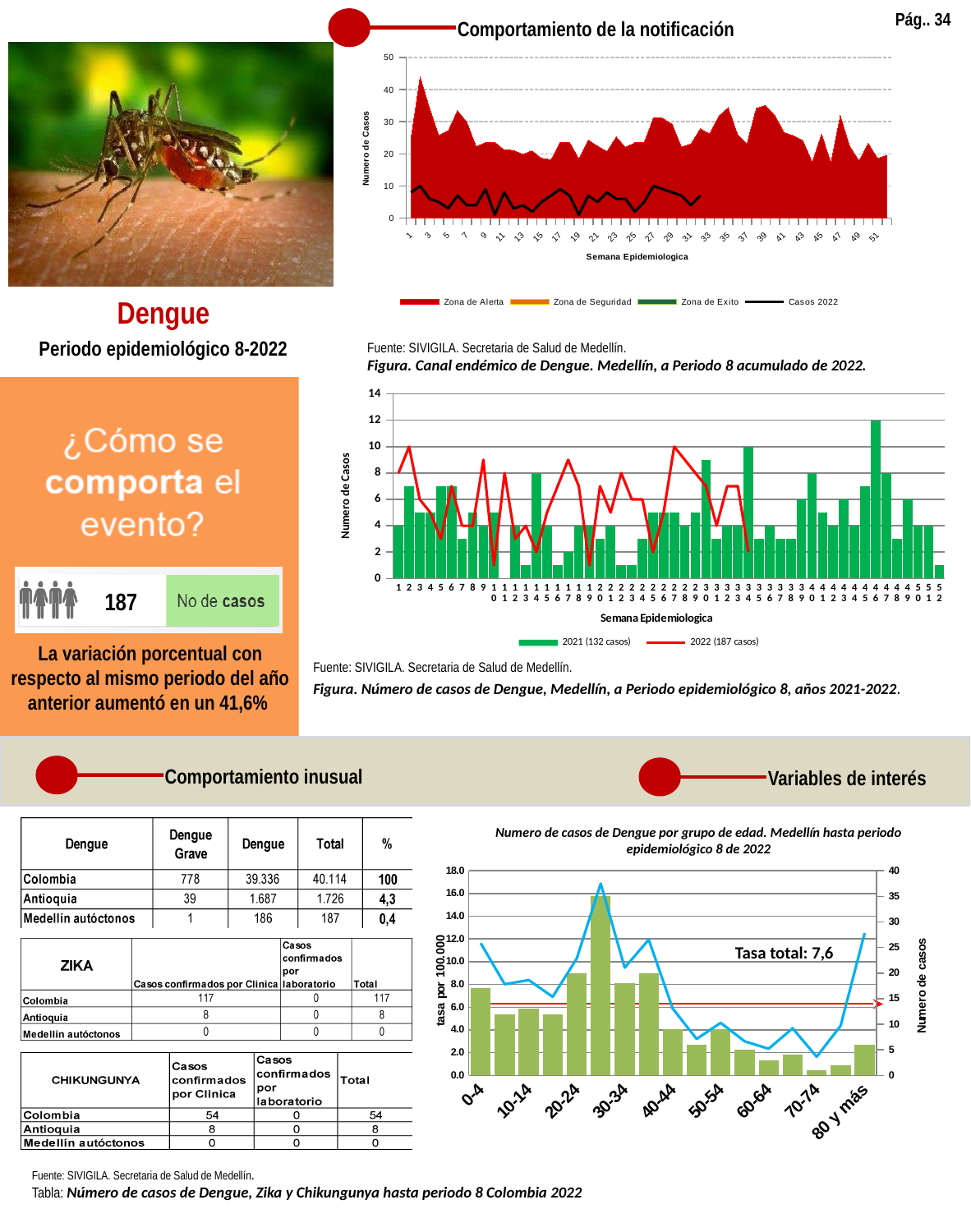
In the 'Número de casos de Dengue, Medellín, a Periodo epidemiológico 8, años 2021-2022' chart, how many total cases does the legend give for 2021? 132 casos In the 'Numero de casos de Dengue por grupo de edad' chart at the bottom right, is the rate (tasa por 100.000) line value for the 0-4 age group greater or less than 10? greater In the 'Canal endémico de Dengue' chart at the top right, is the Zona de Alerta value at week 2 greater or less than 30? greater In the 'Número de casos de Dengue, Medellín, a Periodo epidemiológico 8, años 2021-2022' chart, how many total cases does the legend give for 2022? 187 casos In the 'Número de casos de Dengue, Medellín, a Periodo epidemiológico 8, años 2021-2022' chart, what colour are the 2021 bars? green In the 'Número de casos de Dengue, Medellín, a Periodo epidemiológico 8, años 2021-2022' chart, what is the difference between the 2022 and 2021 totals shown in the legend? 55 In the 'Numero de casos de Dengue por grupo de edad' chart at the bottom right, how many bars are plotted? 17 In the 'Canal endémico de Dengue' chart at the top right, what is the label of the x axis? Semana Epidemiologica In the 'Numero de casos de Dengue por grupo de edad' chart at the bottom right, what is the Tasa total shown? 7,6 In the 'Canal endémico de Dengue' chart at the top right, how many entries does the legend list? 4 In the 'Número de casos de Dengue, Medellín, a Periodo epidemiológico 8, años 2021-2022' chart, how many series does the legend list? 2 In the 'Número de casos de Dengue, Medellín, a Periodo epidemiológico 8, años 2021-2022' chart, which week has the tallest 2021 bar? 46